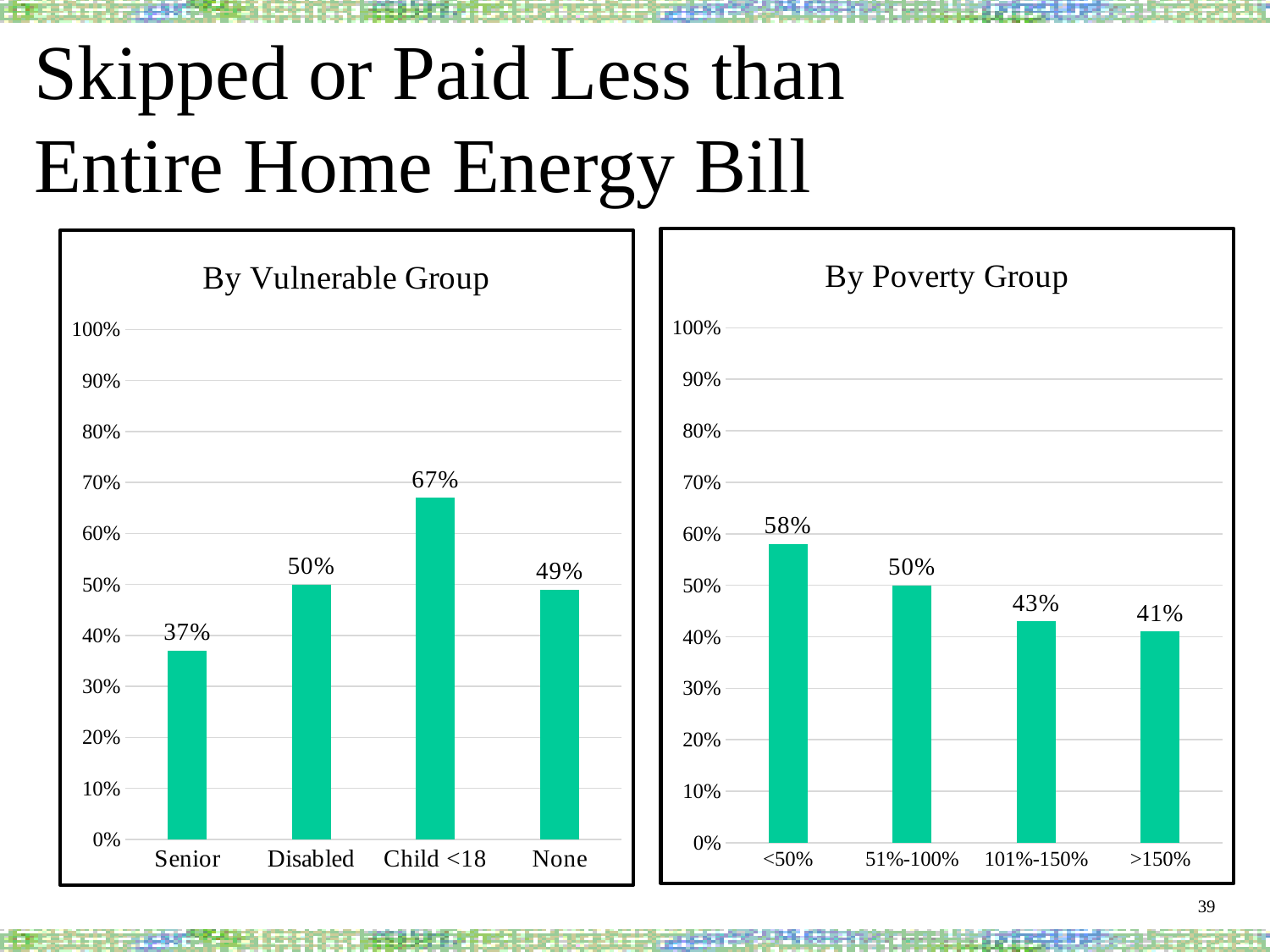
In the 'By Poverty Group' chart, which category has the highest value? <50% In the 'By Vulnerable Group' chart, which category has the lowest value? Senior In the 'By Vulnerable Group' chart, which category has the highest value? Child <18 In the 'By Poverty Group' chart, what is the difference between the values for <50% and 51%-100%? 8% In the 'By Vulnerable Group' chart, what is the difference between the values for Child <18 and Senior? 30% In the 'By Poverty Group' chart, which category has the lowest value? >150% In the 'By Poverty Group' chart, what is the value for 101%-150%? 43% In the 'By Poverty Group' chart, do the values rise or fall from left to right along the x axis? fall In the 'By Vulnerable Group' chart, what is the value for Senior? 37% In the 'By Vulnerable Group' chart, which is larger, the value for Disabled or the value for None? Disabled In the 'By Vulnerable Group' chart, how many categories are shown? 4 What kind of chart is the 'By Poverty Group' chart? bar chart